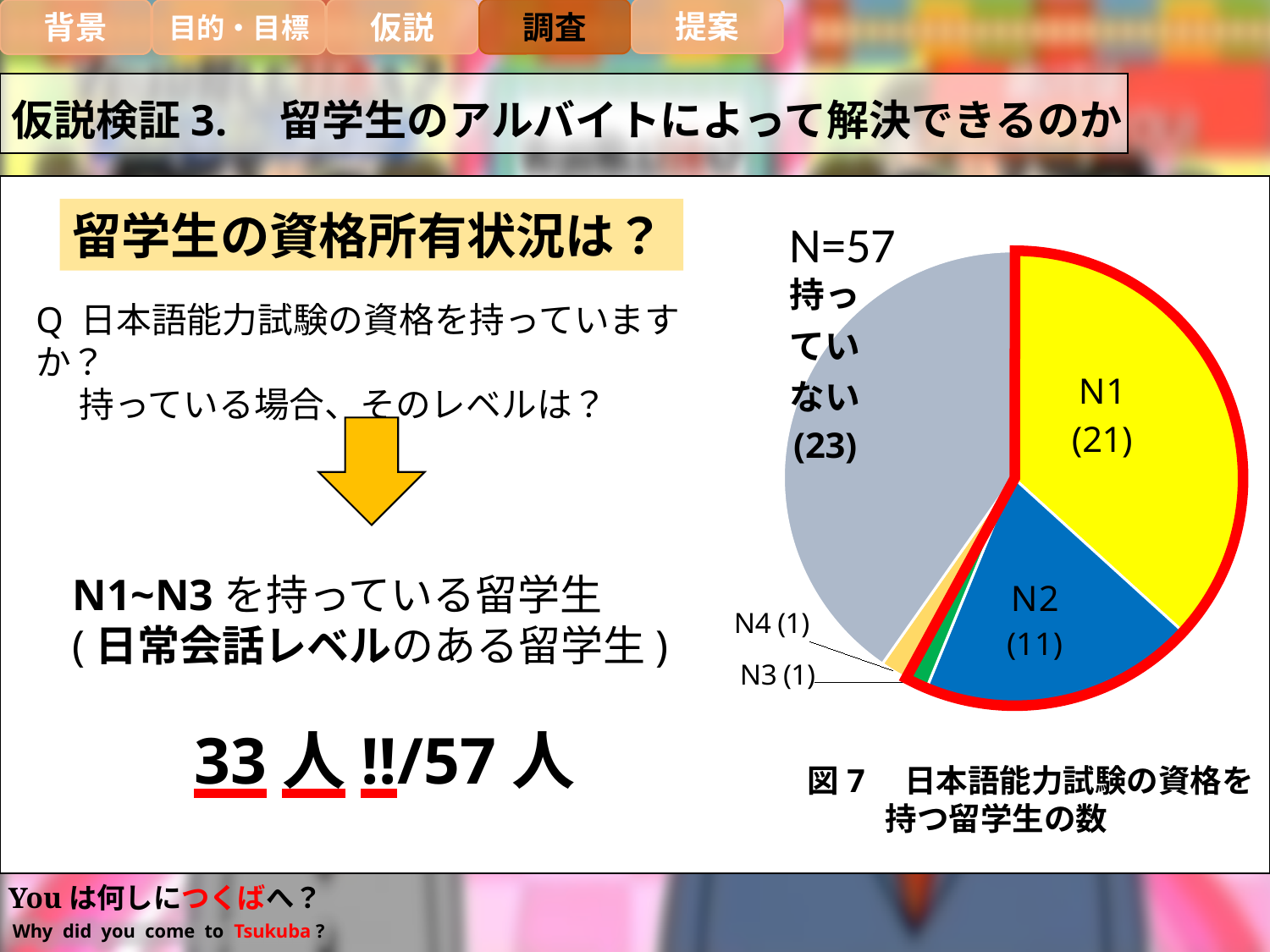
What is the figure caption of the pie chart? 図7 日本語能力試験の資格を持つ留学生の数 What is the difference between the values for 持っていない and N1 in the pie chart? 2 What kind of chart is shown on the slide? pie chart Which is larger in the pie chart, N1 or N2? N1 How many slices does the pie chart have? 5 What is the value for N4 in the pie chart? 1 What is the value for 持っていない in the pie chart? 23 What is the total N shown next to the pie chart? N=57 What is the value for N1 in the pie chart? 21 Which category has the largest slice in the pie chart? 持っていない What is the value for N2 in the pie chart? 11 What is the difference between the values for N1 and N2 in the pie chart? 10